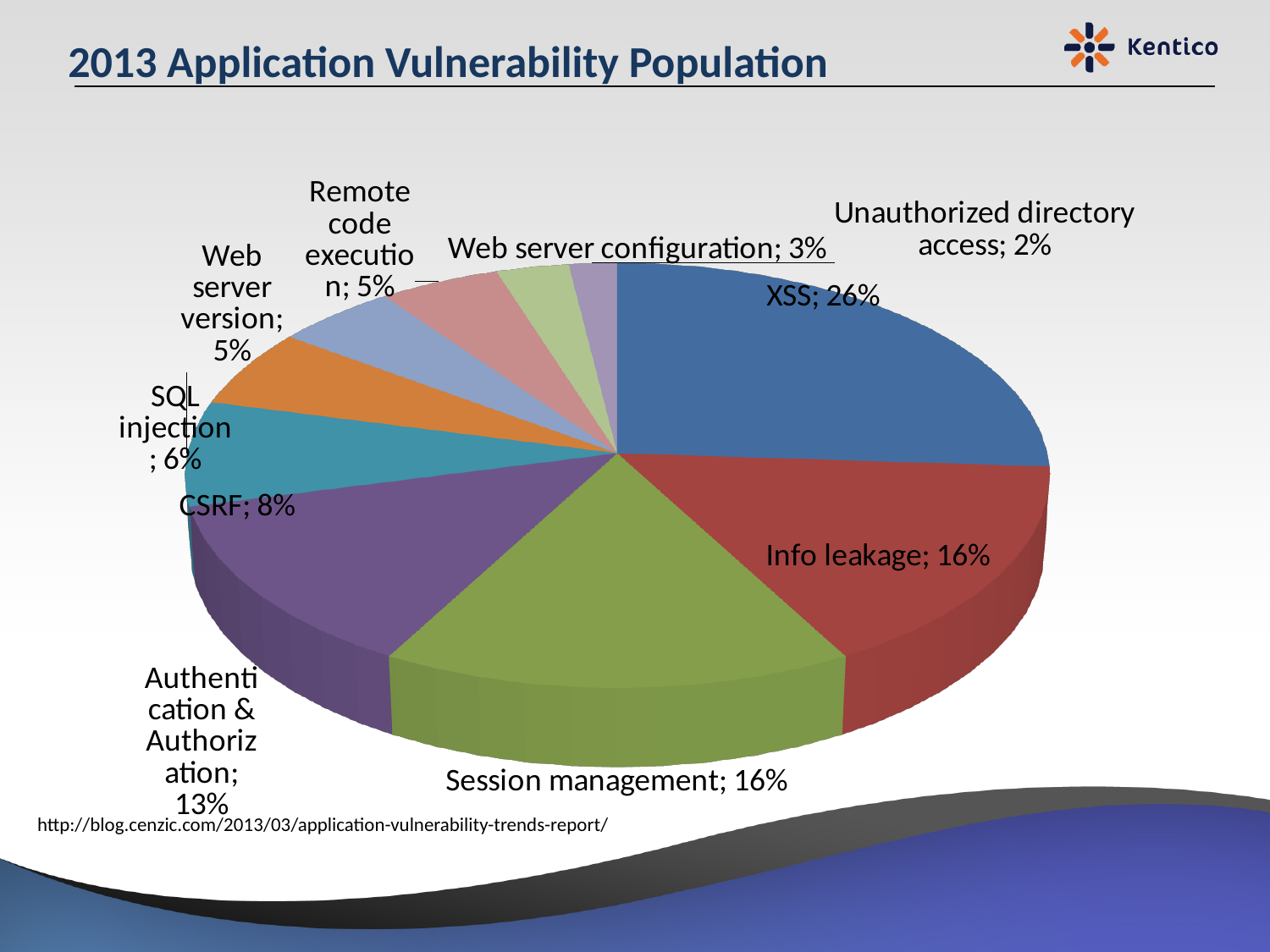
What type of chart is shown on the slide? Pie chart How many slices does the pie chart have? 10 Which vulnerability category has the smallest slice of the pie? Unauthorized directory access What percentage is shown for Info leakage? 16% What share of the pie does XSS account for? 26% What is the difference in percentage points between Authentication & Authorization and CSRF? 5 What is the value labelled for CSRF? 8% Which vulnerability category has the largest slice of the pie? XSS What percentage is shown for Unauthorized directory access? 2% Which is larger, the share for SQL injection or the share for Web server configuration? SQL injection What is the title of the slide containing the chart? 2013 Application Vulnerability Population What is the difference in percentage points between XSS and Info leakage? 10